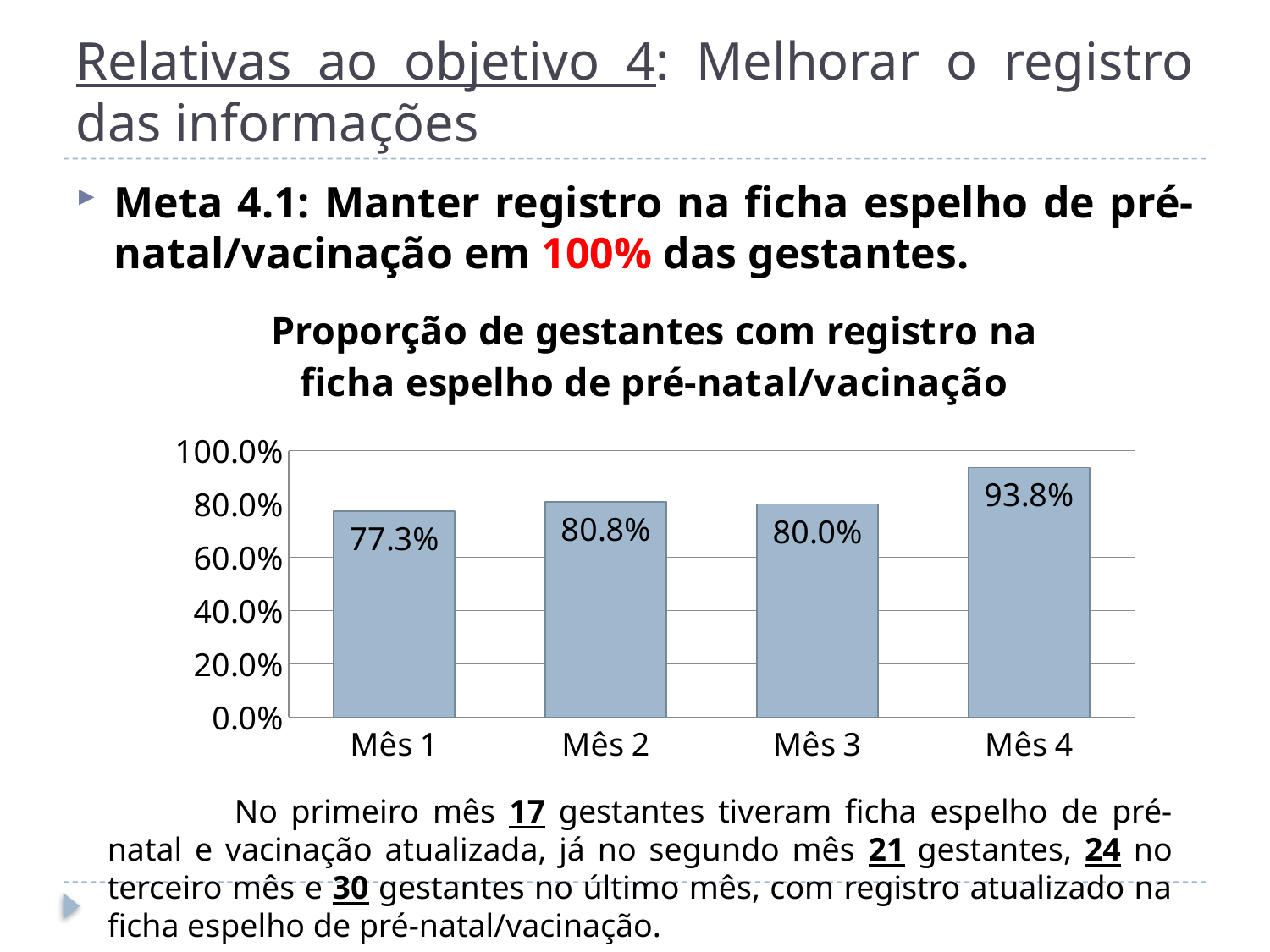
What is the value for Mês 2? 80.8% Which month has the highest proportion? Mês 4 Which is larger, the value for Mês 2 or the value for Mês 3? Mês 2 What is the title of the chart? Proporção de gestantes com registro na ficha espelho de pré-natal/vacinação Is the value for Mês 4 greater or less than 80.0%? greater What is the value for Mês 3? 80.0% What is the difference between the values for Mês 4 and Mês 1? 16.5% What is the value for Mês 4? 93.8% What kind of chart is shown on the slide? bar chart How many months are shown on the x axis? 4 Which month has the lowest proportion? Mês 1 What is the value for Mês 1? 77.3%